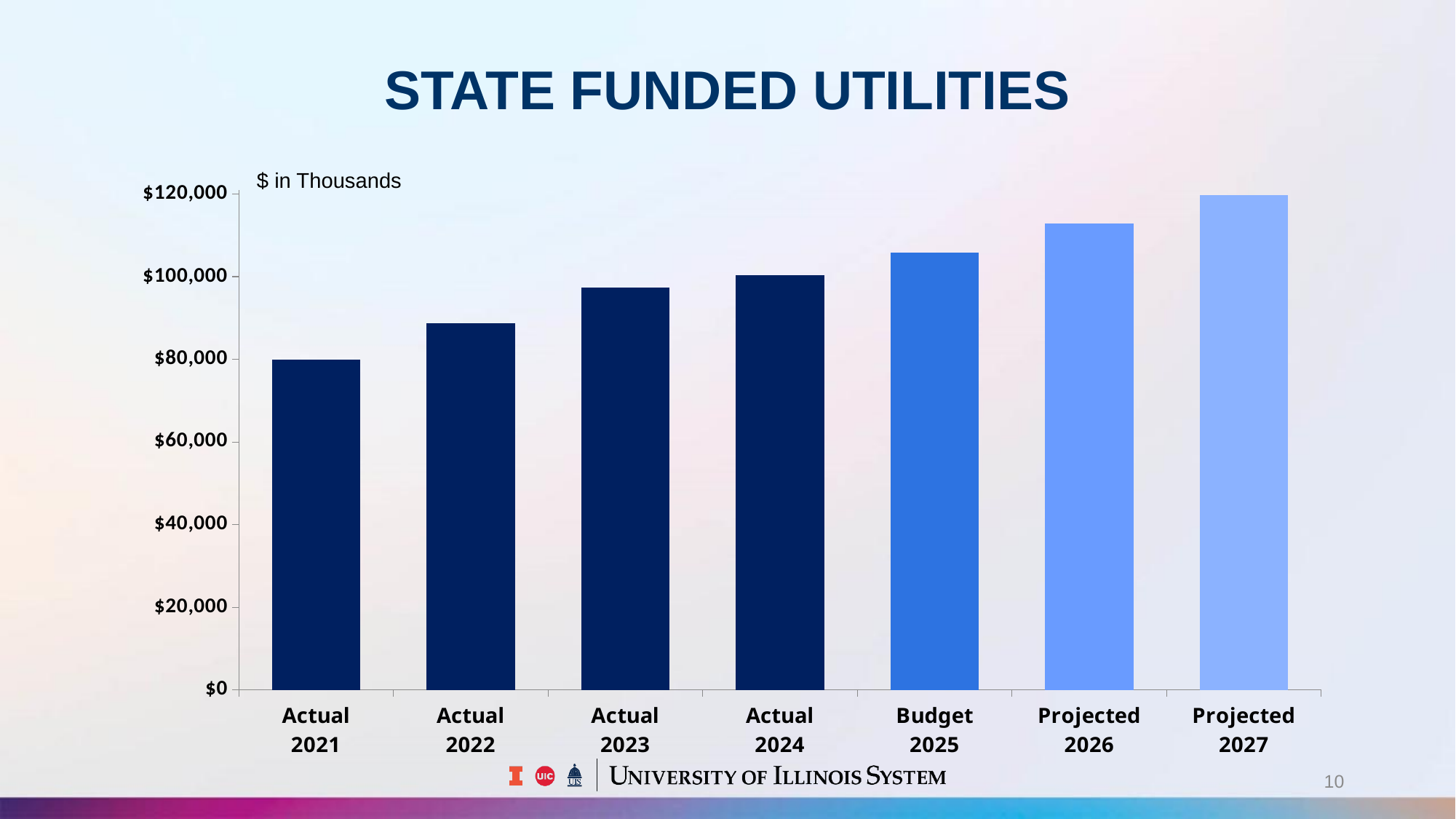
Do the values rise or fall from Actual 2021 to Projected 2027? rise Which category has the highest value? Projected 2027 Is the value for Actual 2023 greater or less than $80,000? greater What is the title of the chart? STATE FUNDED UTILITIES Which category has the lowest value? Actual 2021 In what units are the values on the chart expressed, according to the note above the axis? $ in Thousands Is the value for Actual 2022 greater or less than $100,000? less How many bars (categories) are shown in the chart? 7 What kind of chart is shown on the slide? bar chart Which is larger, the value for Budget 2025 or the value for Actual 2023? Budget 2025 Is the value for Budget 2025 greater or less than $120,000? less